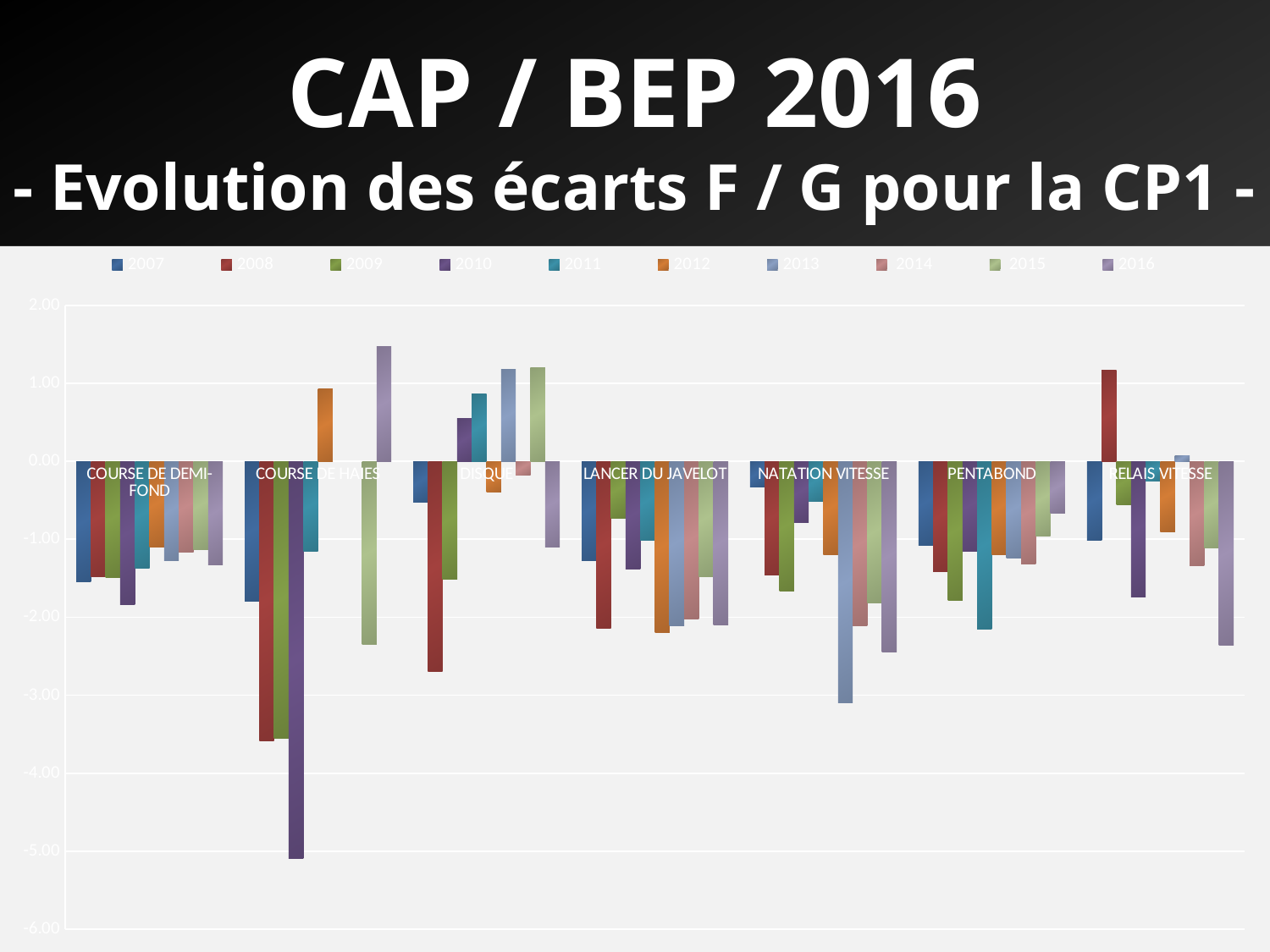
Which year does the first legend entry show? 2007 What kind of chart is shown on the slide? bar chart Is the value for 2016 in COURSE DE HAIES greater or less than 1.00? greater Which year does the last legend entry show? 2016 Which is lower, the value for 2010 in COURSE DE HAIES or the value for 2010 in COURSE DE DEMI-FOND? 2010 in COURSE DE HAIES Which series has the highest value in the COURSE DE HAIES category? 2016 Is the value for 2010 in COURSE DE HAIES greater or less than -4.00? less Which category contains the lowest bar in the chart? COURSE DE HAIES Is the value for 2013 in NATATION VITESSE greater or less than -2.00? less Which series has the lowest value in the COURSE DE HAIES category? 2010 How many categories (events) are shown along the x axis of the chart? 7 How many series does the chart legend list? 10